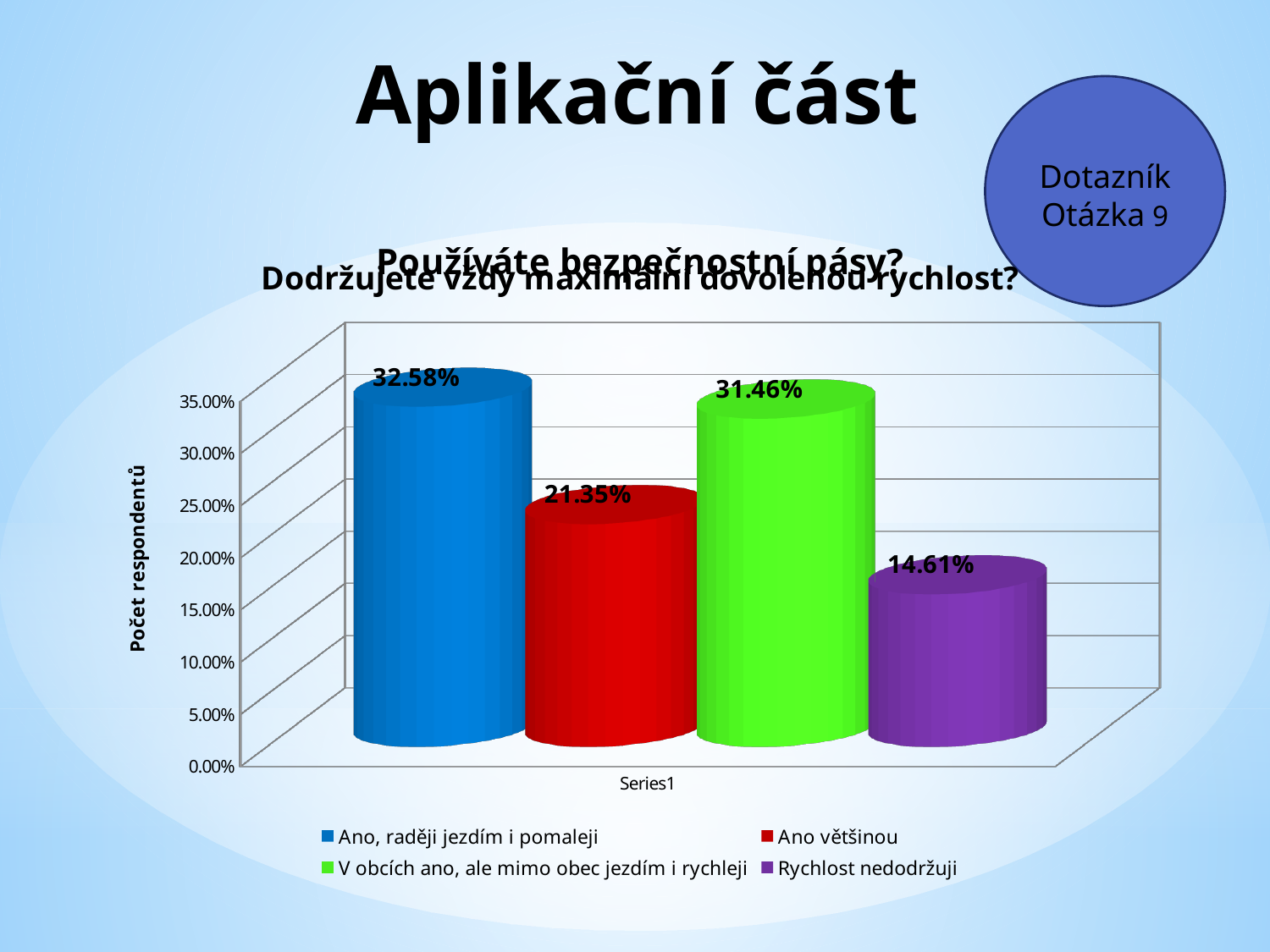
What is the label on the vertical axis of the chart? Počet respondentů What value is shown for "V obcích ano, ale mimo obec jezdím i rychleji"? 31.46% What value is shown for "Ano většinou"? 21.35% What kind of chart is shown on the slide? Bar chart How many entries does the legend list? 4 What is the difference between the values for "Ano, raději jezdím i pomaleji" and "Rychlost nedodržuji"? 17.97% What value is shown for "Rychlost nedodržuji"? 14.61% What value is shown for "Ano, raději jezdím i pomaleji"? 32.58% What is the difference between the values for "V obcích ano, ale mimo obec jezdím i rychleji" and "Ano většinou"? 10.11% Which is larger, the value for "Ano většinou" or the value for "Rychlost nedodržuji"? Ano většinou Which legend entry has the highest value? Ano, raději jezdím i pomaleji Which legend entry has the lowest value? Rychlost nedodržuji